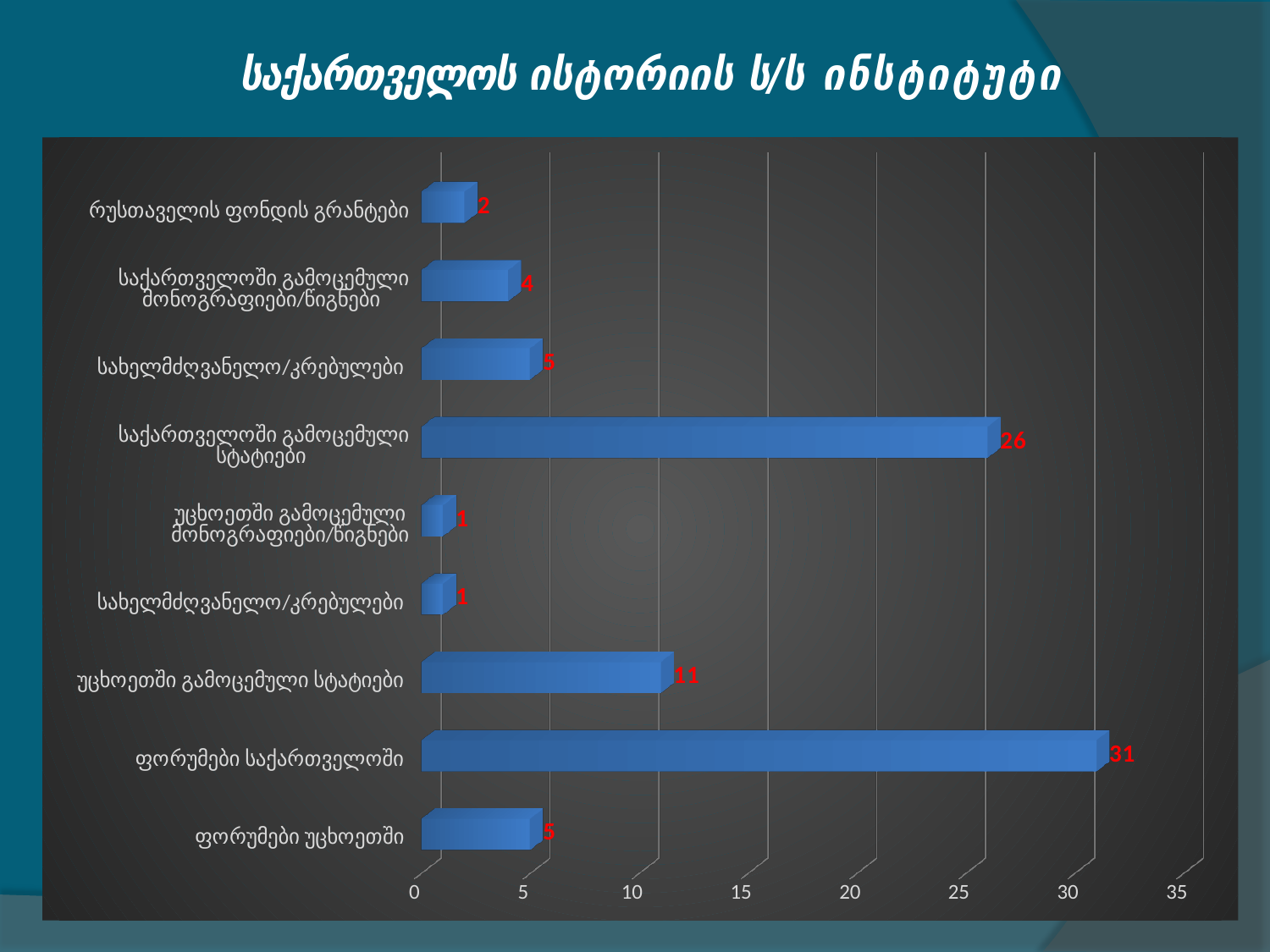
What type of chart is shown on the slide? bar chart What is the title of the slide? საქართველოს ისტორიის ს/ს ინსტიტუტი Which category has the highest value? ფორუმები საქართველოში How many categories are plotted in the chart? 9 What is the value for საქართველოში გამოცემული სტატიები? 26 What is the value for უცხოეთში გამოცემული სტატიები? 11 What is the difference between ფორუმები საქართველოში and ფორუმები უცხოეთში? 26 What is the difference between საქართველოში გამოცემული მონოგრაფიები/წიგნები and უცხოეთში გამოცემული მონოგრაფიები/წიგნები? 3 What is the value for ფორუმები საქართველოში? 31 Which is larger: საქართველოში გამოცემული სტატიები or უცხოეთში გამოცემული სტატიები? საქართველოში გამოცემული სტატიები What is the value for ფორუმები უცხოეთში? 5 What is the value for რუსთაველის ფონდის გრანტები? 2